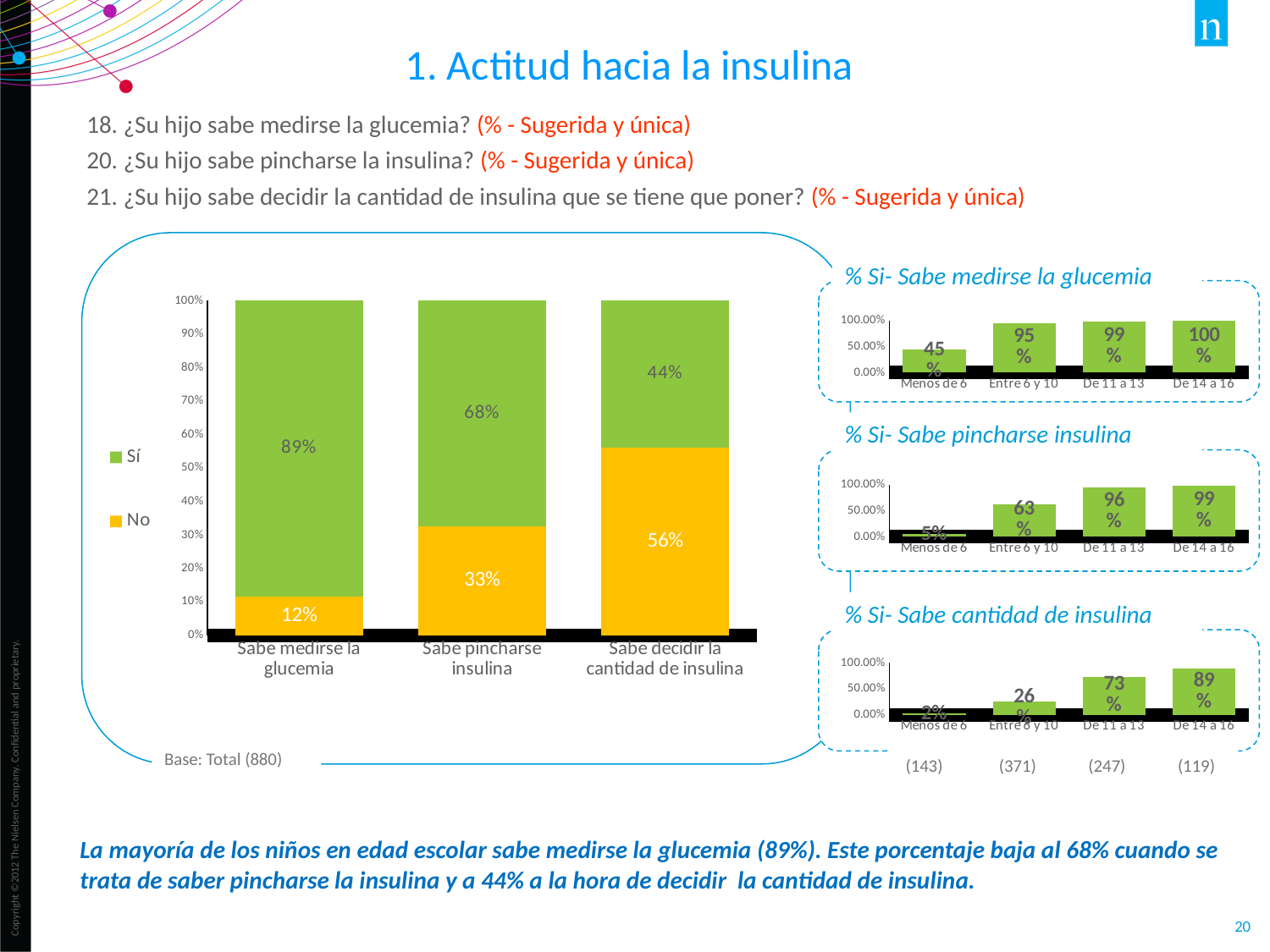
In the chart titled '% Si- Sabe pincharse insulina', what is the value for 'Entre 6 y 10'? 63% What kind of chart is the main chart on the left of the slide? Stacked bar chart In the main stacked bar chart on the left, what is the 'No' value for 'Sabe pincharse insulina'? 33% In the main stacked bar chart on the left, what is the difference between the 'Sí' values for 'Sabe medirse la glucemia' and 'Sabe decidir la cantidad de insulina'? 45% In the chart titled '% Si- Sabe cantidad de insulina', do the values rise or fall from 'Menos de 6' to 'De 14 a 16'? Rise In the main stacked bar chart on the left, which category has the highest 'No' value? Sabe decidir la cantidad de insulina In the main stacked bar chart on the left, how many series does the legend list? 2 How many age-group categories are shown in the chart titled '% Si- Sabe pincharse insulina'? 4 In the main stacked bar chart on the left, is the 'Sí' value for 'Sabe pincharse insulina' larger than the 'No' value for the same category? Yes, Sí (68%) is larger In the chart titled '% Si- Sabe cantidad de insulina', which age group has the lowest value? Menos de 6 In the main stacked bar chart on the left, what is the 'Sí' value for 'Sabe medirse la glucemia'? 89% In the chart titled '% Si- Sabe medirse la glucemia', what is the value for 'Menos de 6'? 45%